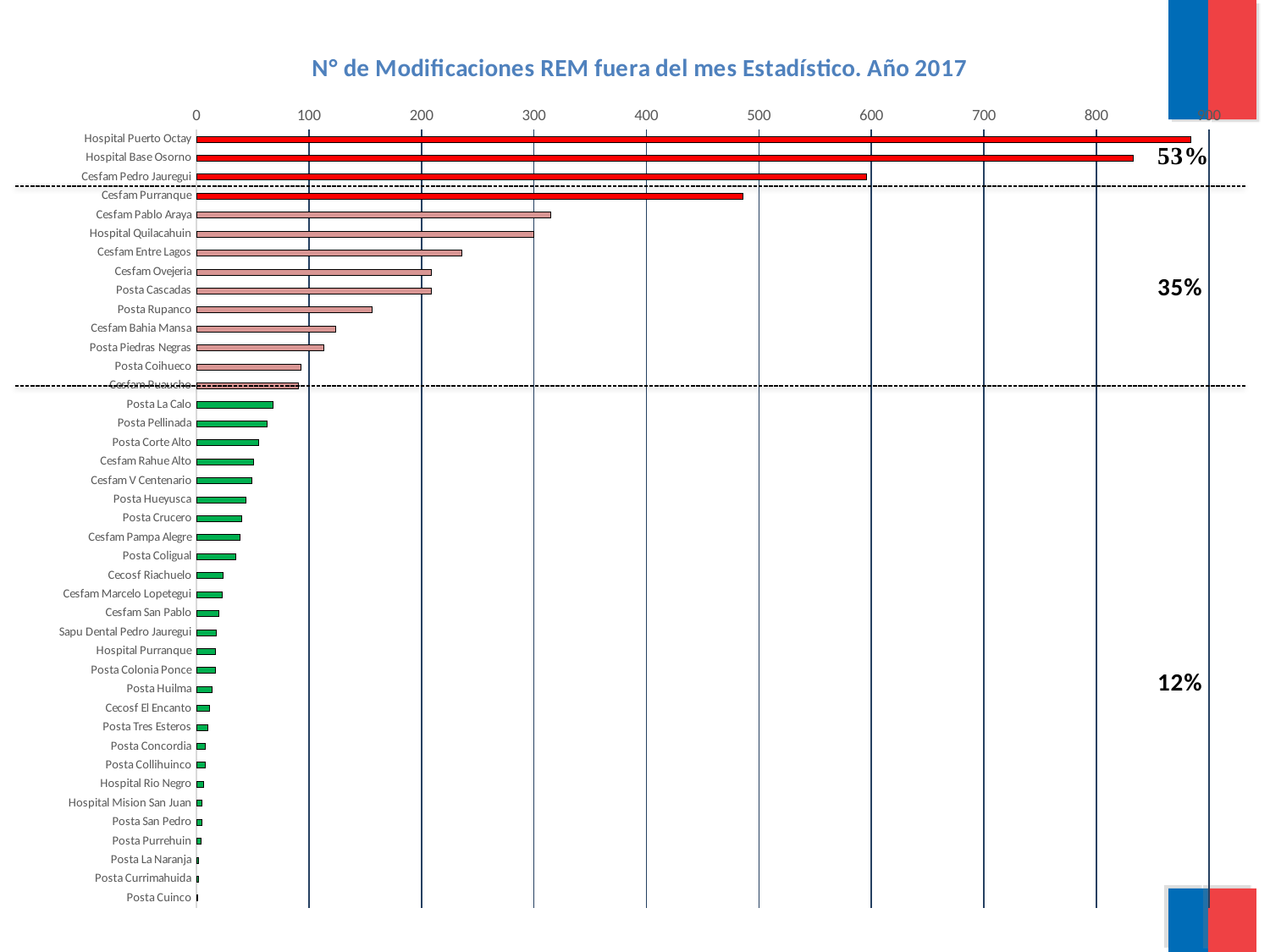
What kind of chart is shown on the slide? bar chart Which has a larger value, Cesfam Purranque or Cesfam Pablo Araya? Cesfam Purranque What is the title of the chart? N° de Modificaciones REM fuera del mes Estadístico. Año 2017 What percentage label is shown next to the top group of red bars? 53% Which establishment has the highest number of modificaciones REM? Hospital Puerto Octay Is the value for Cesfam Entre Lagos greater or less than 200? greater Which has a larger value, Hospital Base Osorno or Cesfam Pedro Jauregui? Hospital Base Osorno Is the value for Posta Rupanco greater or less than 200? less Which establishment has the lowest number of modificaciones REM? Posta Cuinco Is the value for Posta La Calo greater or less than 100? less